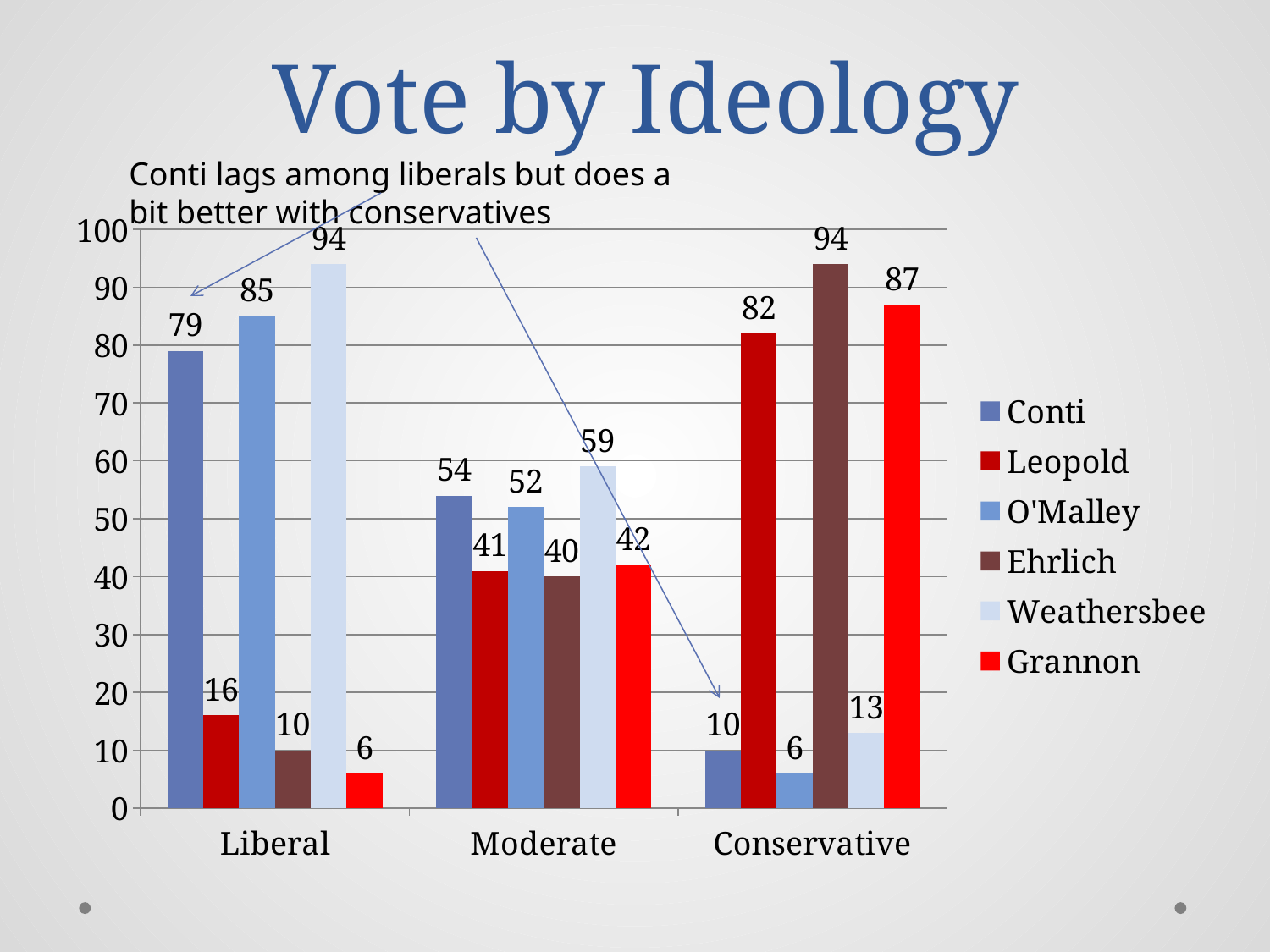
What is the value for Grannon among Liberal voters? 6 Does the value for Conti rise or fall from Liberal to Conservative? Fall What is the value for Weathersbee among Moderate voters? 59 How many series does the legend list? 6 What is the value for Ehrlich among Conservative voters? 94 What is the value for Conti among Liberal voters? 79 Which series has the lowest value in the Conservative category? O'Malley What is the difference between Leopold's and Conti's values among Conservative voters? 72 Which series has the highest value in the Liberal category? Weathersbee Among Moderate voters, which is larger: the value for Conti or the value for O'Malley? Conti How many ideology categories are shown on the x axis? 3 What kind of chart is shown on the slide? Bar chart